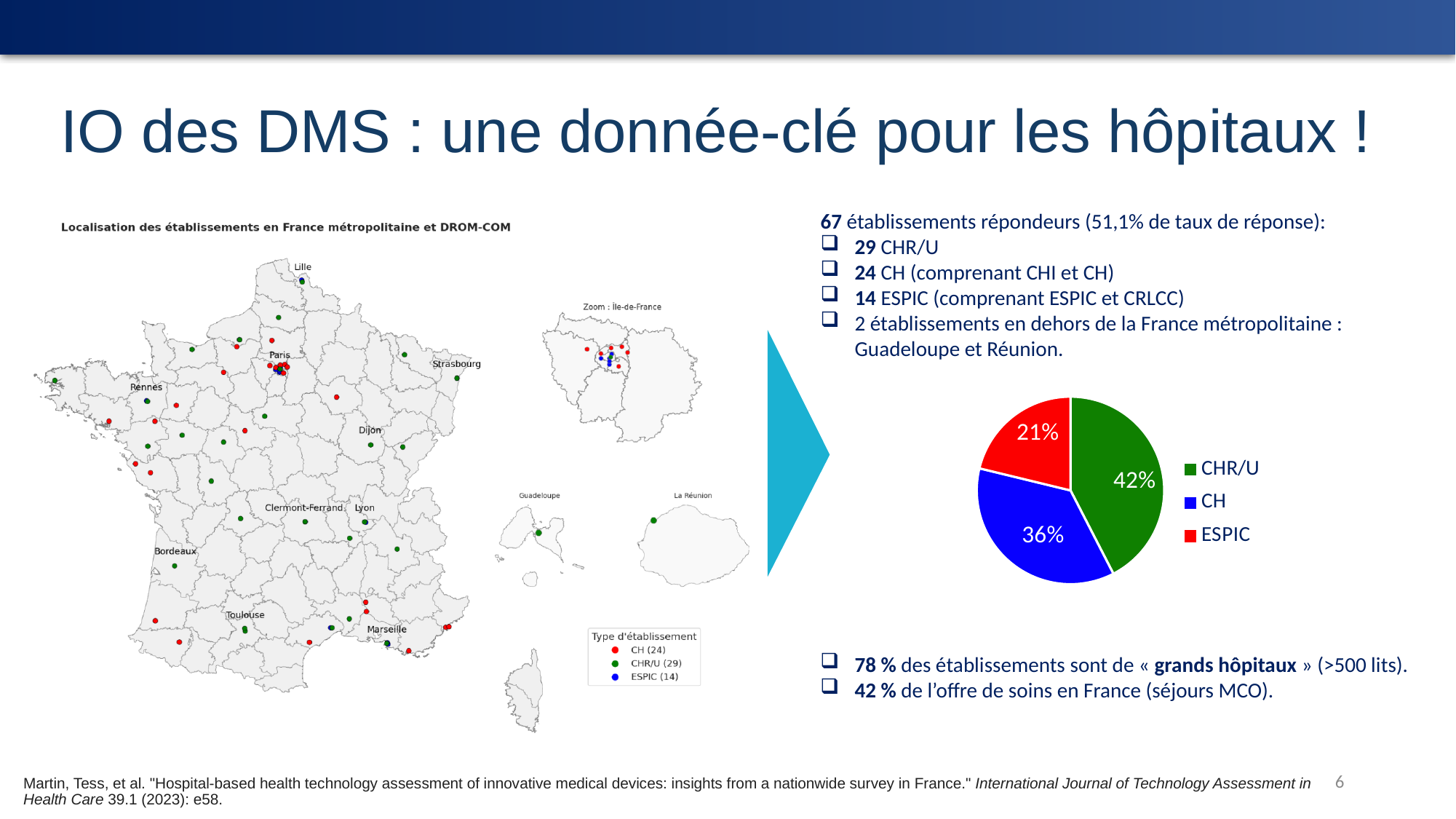
What kind of chart is shown on the right side of the slide? Pie chart In the pie chart, what is the difference in percentage points between the CHR/U slice and the CH slice? 6 In the pie chart, what share is shown for CH? 36% How many slices does the pie chart have? 3 In the pie chart, what is the difference in percentage points between the CHR/U slice and the ESPIC slice? 21 In the pie chart, which category has the largest slice? CHR/U In the pie chart, what share is shown for CHR/U? 42% In the pie chart, what share is shown for ESPIC? 21% How many entries does the legend of the pie chart list? 3 In the pie chart, which slice is larger, CH or ESPIC? CH In the pie chart, which category has the smallest slice? ESPIC In the pie chart, what colour is the CH slice? Blue